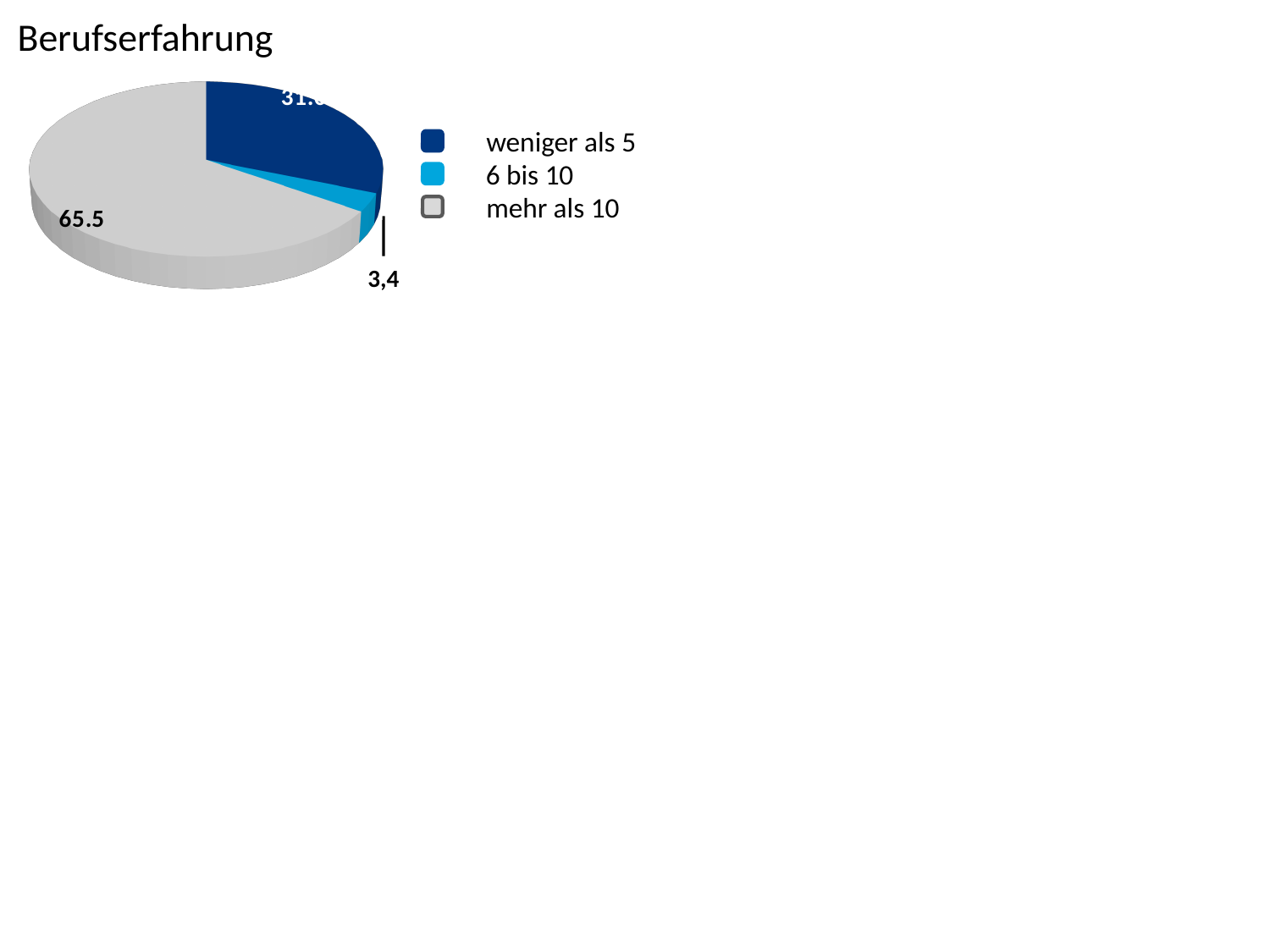
How many categories does the pie chart show? 3 What is the difference between the values for "mehr als 10" and "6 bis 10"? 62.1 What kind of chart is shown on the slide? Pie chart What colour is the "mehr als 10" slice? Grey What is the value shown for the "6 bis 10" slice? 3,4 What is the title of the chart? Berufserfahrung What is the value shown for the "mehr als 10" slice? 65.5 Which category has the smallest slice of the pie? 6 bis 10 How many entries does the legend list? 3 Which category has the largest slice of the pie? mehr als 10 Which slice is larger, "weniger als 5" or "6 bis 10"? weniger als 5 Which slice is larger, "mehr als 10" or "weniger als 5"? mehr als 10